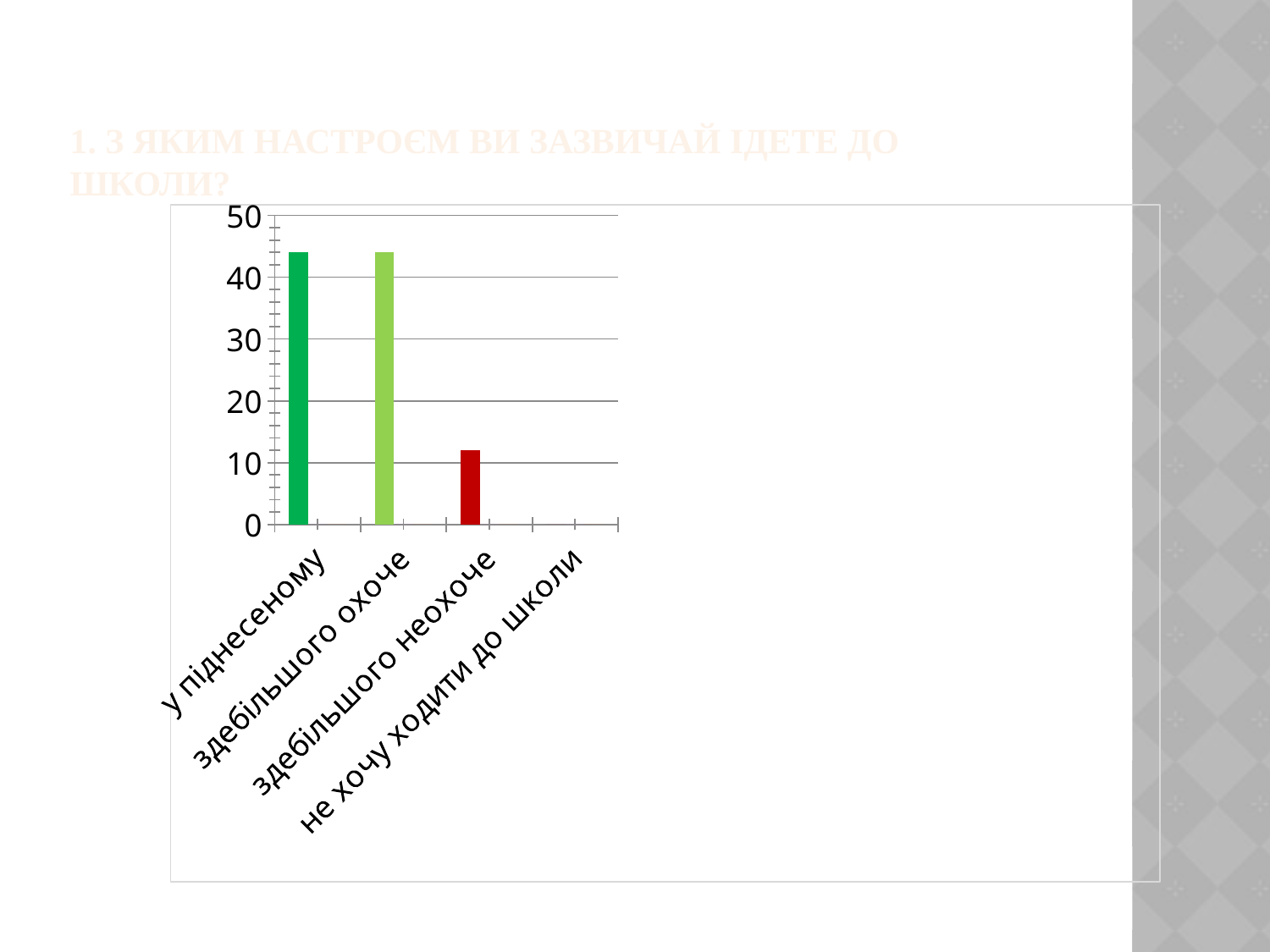
Which category has the lowest value in the chart? не хочу ходити до школи How many categories are shown on the x axis of the chart? 4 What kind of chart is shown on the slide? bar chart Is the value for "здебільшого неохоче" greater or less than 20? less Is the value for "у піднесеному" greater or less than 40? greater What colour is the bar for "здебільшого неохоче"? red Which is larger, the value for "здебільшого охоче" or the value for "здебільшого неохоче"? здебільшого охоче What is the highest value shown on the vertical axis of the chart? 50 Do the values generally rise or fall from left to right along the x axis? fall Is the value for "здебільшого охоче" greater or less than 40? greater What is the value for "не хочу ходити до школи"? 0